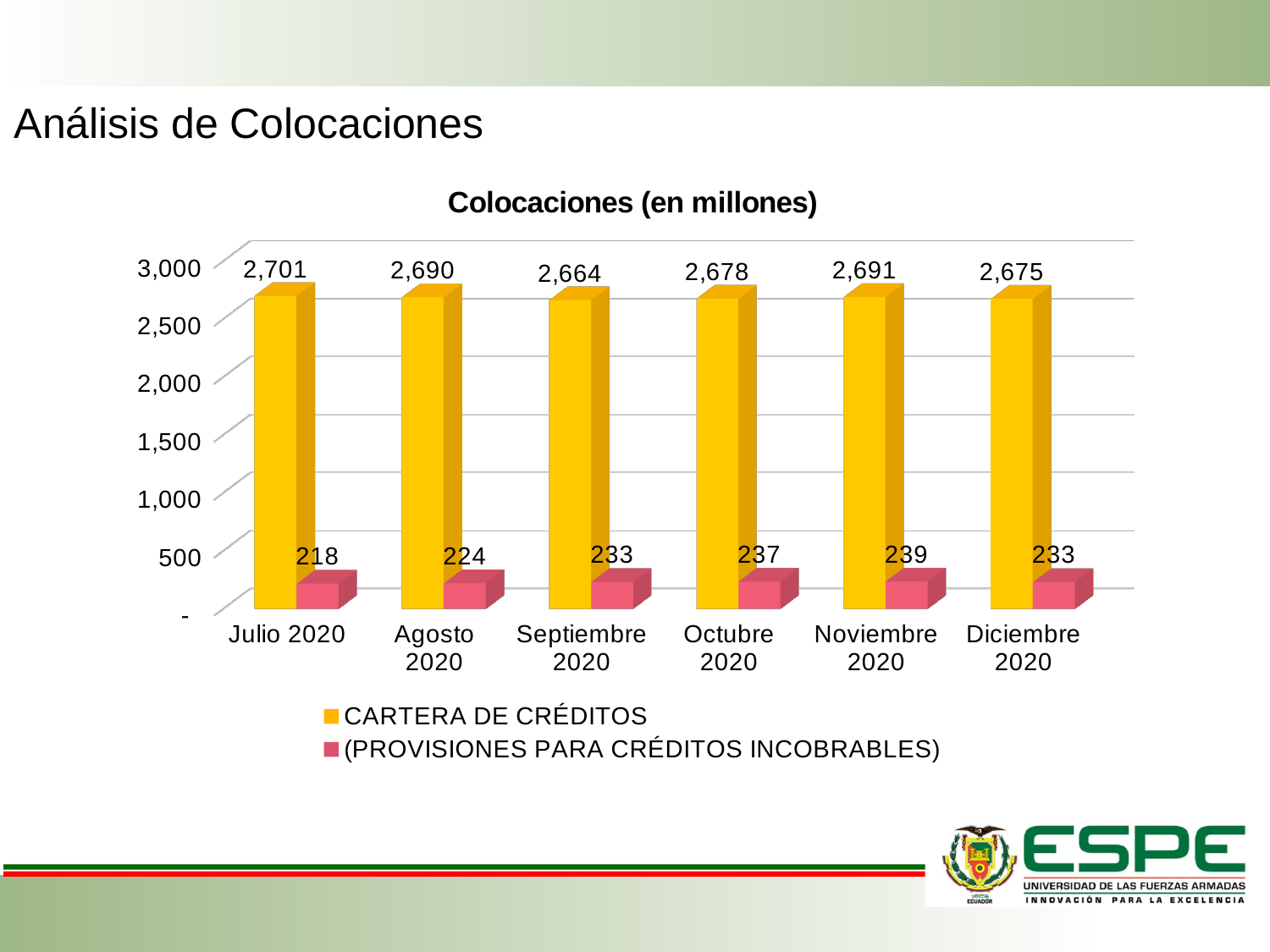
What is the value of (PROVISIONES PARA CRÉDITOS INCOBRABLES) for Noviembre 2020? 239 What is the value of CARTERA DE CRÉDITOS for Septiembre 2020? 2,664 What is the difference between the CARTERA DE CRÉDITOS values for Julio 2020 and Septiembre 2020? 37 Which month has the lowest value for (PROVISIONES PARA CRÉDITOS INCOBRABLES)? Julio 2020 How many months are shown on the x axis? 6 Is the CARTERA DE CRÉDITOS value for Diciembre 2020 greater or less than 2,500? greater What is the title of the chart? Colocaciones (en millones) Which month has the highest value for CARTERA DE CRÉDITOS? Julio 2020 Which is larger, the (PROVISIONES PARA CRÉDITOS INCOBRABLES) value for Octubre 2020 or for Agosto 2020? Octubre 2020 How many series does the legend list? 2 What is the value of CARTERA DE CRÉDITOS for Julio 2020? 2,701 What kind of chart is shown on the slide? bar chart